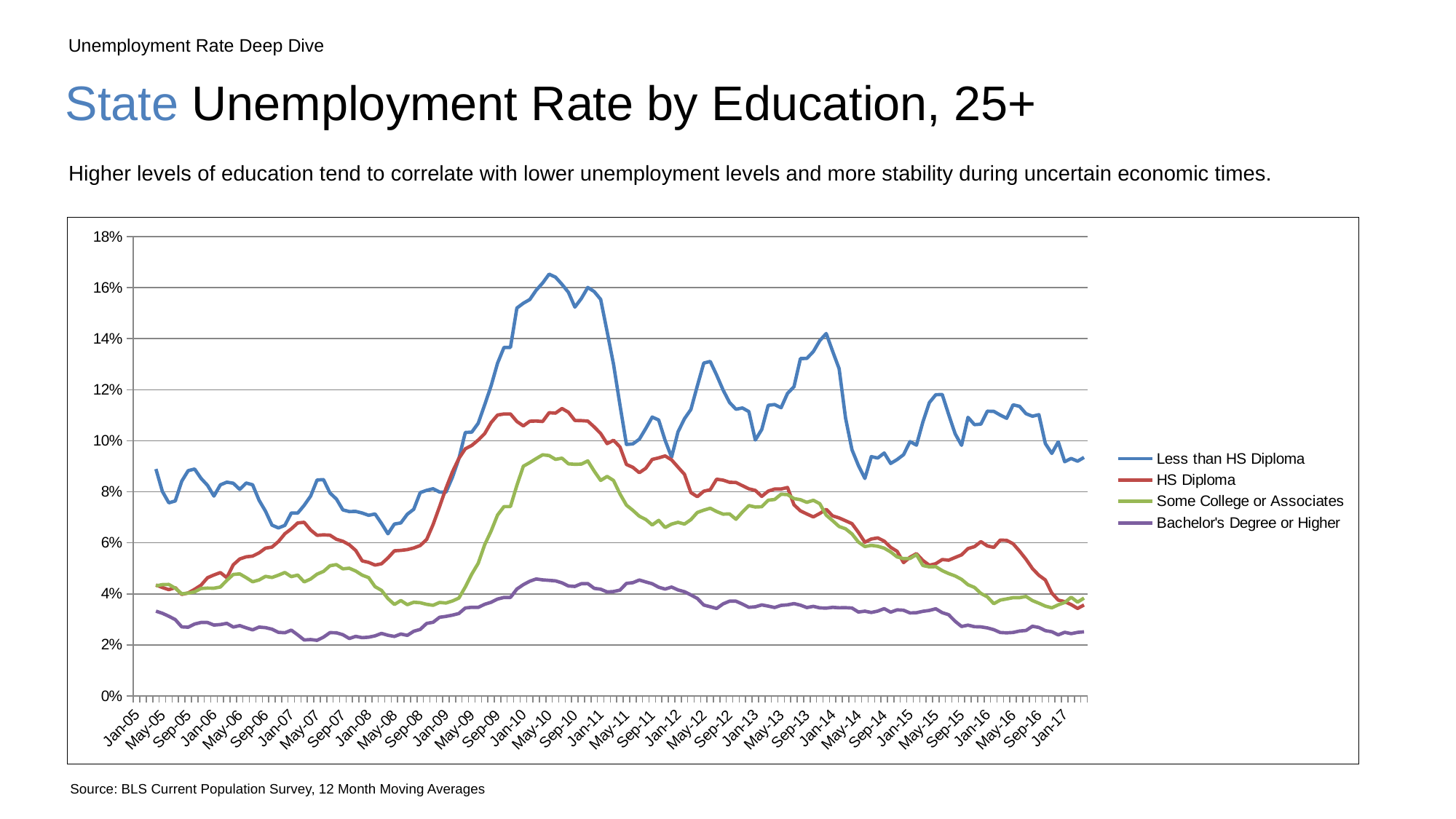
Is the peak value for Less than HS Diploma greater or less than 16%? greater Which education group has the lowest unemployment rate across the whole period? Bachelor's Degree or Higher How many series does the legend list? 4 Between Jan-08 and May-10, does the Less than HS Diploma line rise or fall? rise Around Jan-17, is the value for Some College or Associates greater or less than 6%? less Between May-13 and Jan-17, does the HS Diploma line rise or fall overall? fall Around Jan-14, which is higher: Less than HS Diploma or HS Diploma? Less than HS Diploma Which education group has the highest unemployment rate across the whole period? Less than HS Diploma Is the highest value reached by Bachelor's Degree or Higher greater or less than 6%? less What kind of chart is shown on the slide? line chart Which series is drawn in purple? Bachelor's Degree or Higher